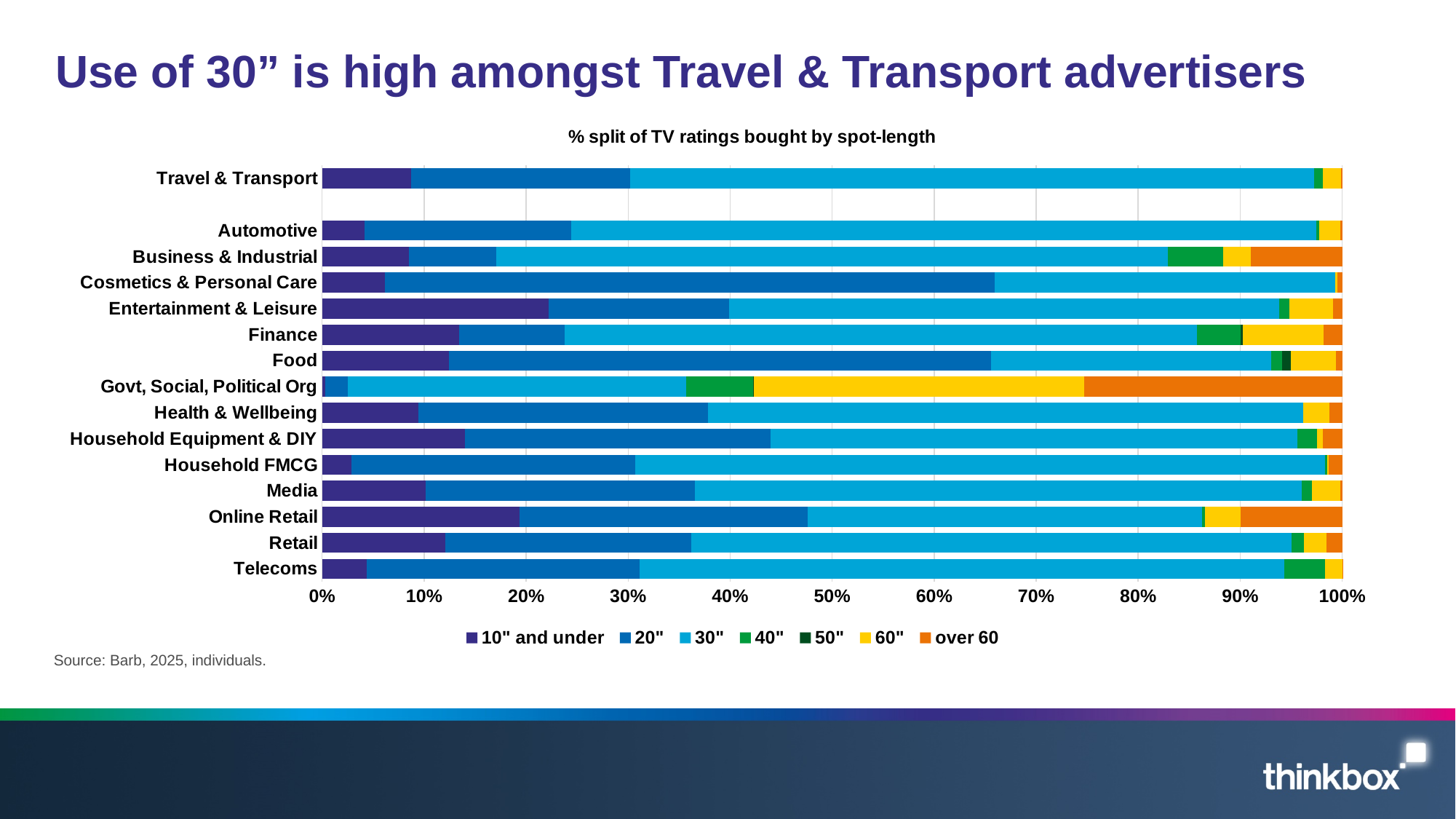
What is the title of the chart? % split of TV ratings bought by spot-length Which category has the largest '60"' segment? Govt, Social, Political Org How many advertiser categories are plotted on the chart? 15 Is the '10" and under' share for Entertainment & Leisure greater or less than 20%? greater Which category has the largest 'over 60' segment? Govt, Social, Political Org Is the '10" and under' share for Automotive greater or less than 10%? less Which has the larger 'over 60' share, Online Retail or Travel & Transport? Online Retail How many series does the legend list? 7 Which has the larger '10" and under' share, Entertainment & Leisure or Automotive? Entertainment & Leisure Is the combined share of '10" and under' and '20"' for Cosmetics & Personal Care greater or less than 60%? greater Which category has the largest '10" and under' segment? Entertainment & Leisure What kind of chart is shown on the slide? Stacked bar chart